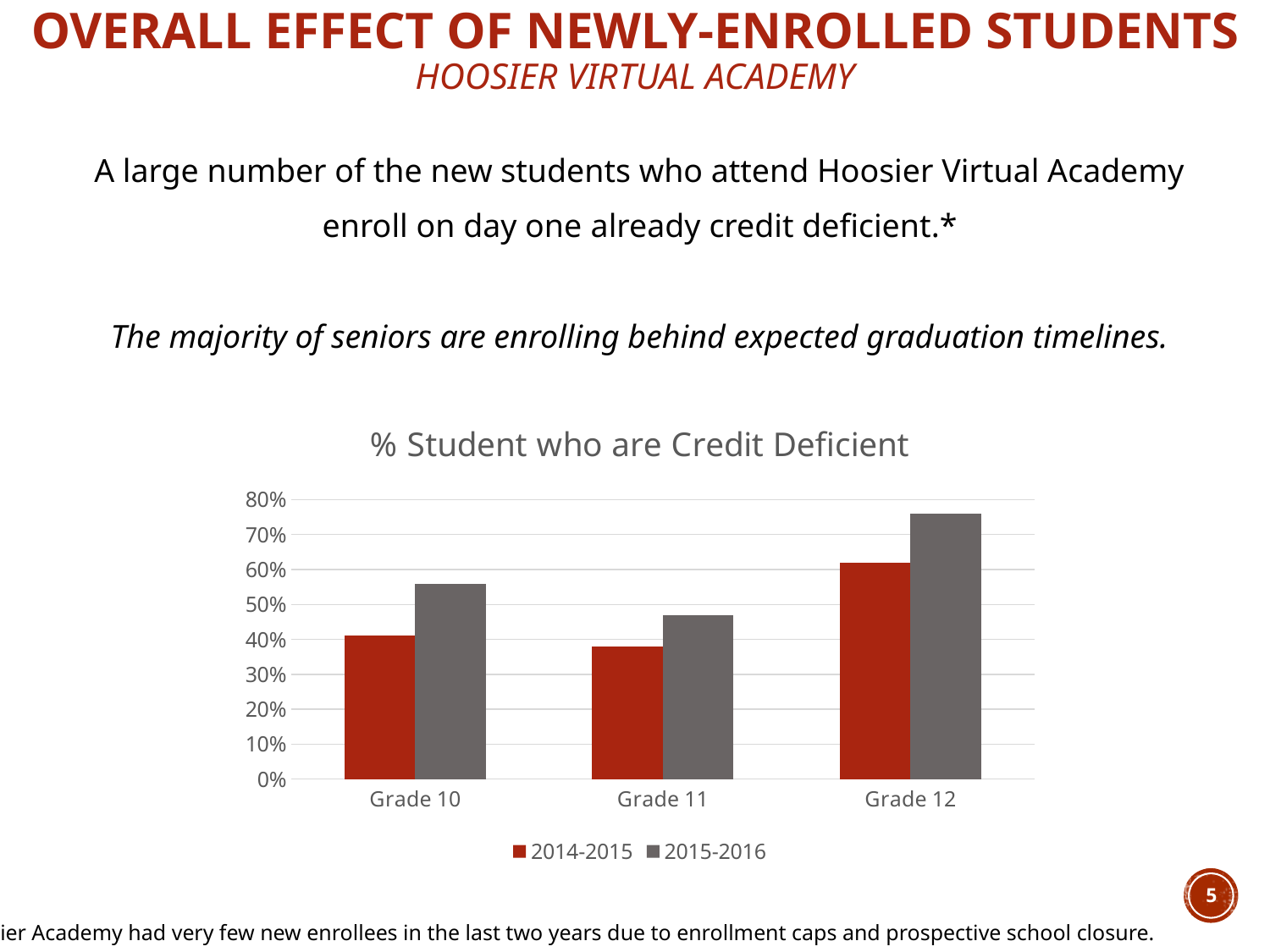
Is the value for Grade 10 in 2015-2016 greater or less than 50%? greater Is the value for Grade 12 in 2014-2015 greater or less than 50%? greater For Grade 12, which series has the larger value, 2014-2015 or 2015-2016? 2015-2016 How many grade categories are shown on the x axis of the chart? 3 Is the value for Grade 12 in 2015-2016 greater or less than 70%? greater Which grade has the lowest value for the 2014-2015 series? Grade 11 Which series is shown in red in the chart? 2014-2015 What is the title of the chart? % Student who are Credit Deficient What kind of chart is shown on the slide? bar chart How many series does the chart legend list? 2 Which grade has the highest value for the 2015-2016 series? Grade 12